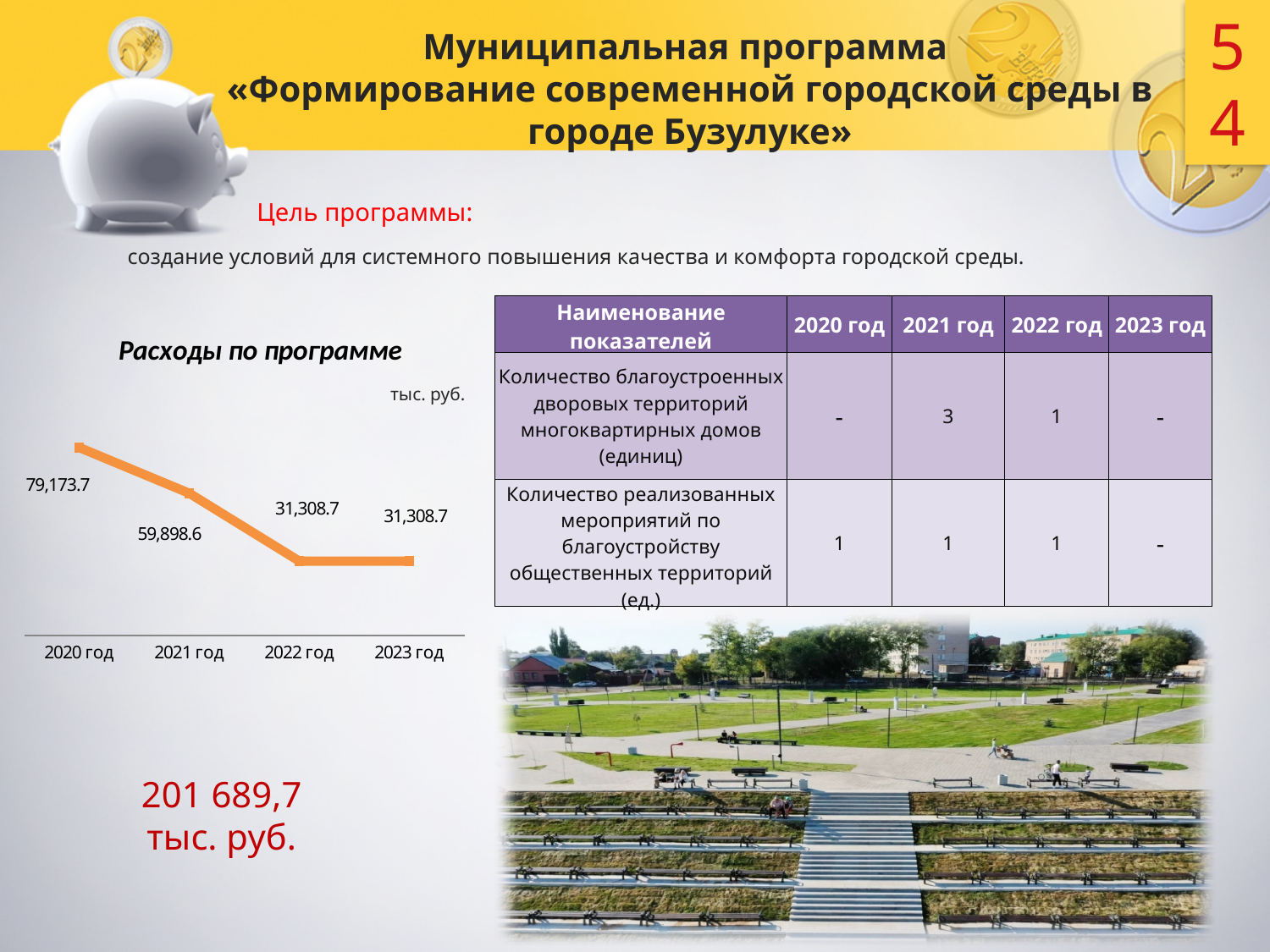
In the chart "Расходы по программе", what is the difference between the values for 2020 год and 2021 год? 19,275.1 In the chart "Расходы по программе", which is larger, the value for 2020 год or 2021 год? 2020 год What type of chart is "Расходы по программе"? line chart In the chart "Расходы по программе", what is the value for 2020 год? 79,173.7 In the chart "Расходы по программе", what is the value for 2021 год? 59,898.6 What unit of measurement is shown for the chart "Расходы по программе"? тыс. руб. How many years are plotted in the chart "Расходы по программе"? 4 In the chart "Расходы по программе", which year has the highest value? 2020 год In the chart "Расходы по программе", what is the value for 2023 год? 31,308.7 In the chart "Расходы по программе", do the values rise or fall from 2020 год to 2022 год? fall In the chart "Расходы по программе", what is the value for 2022 год? 31,308.7 In the chart "Расходы по программе", what is the difference between the values for 2021 год and 2022 год? 28,589.9